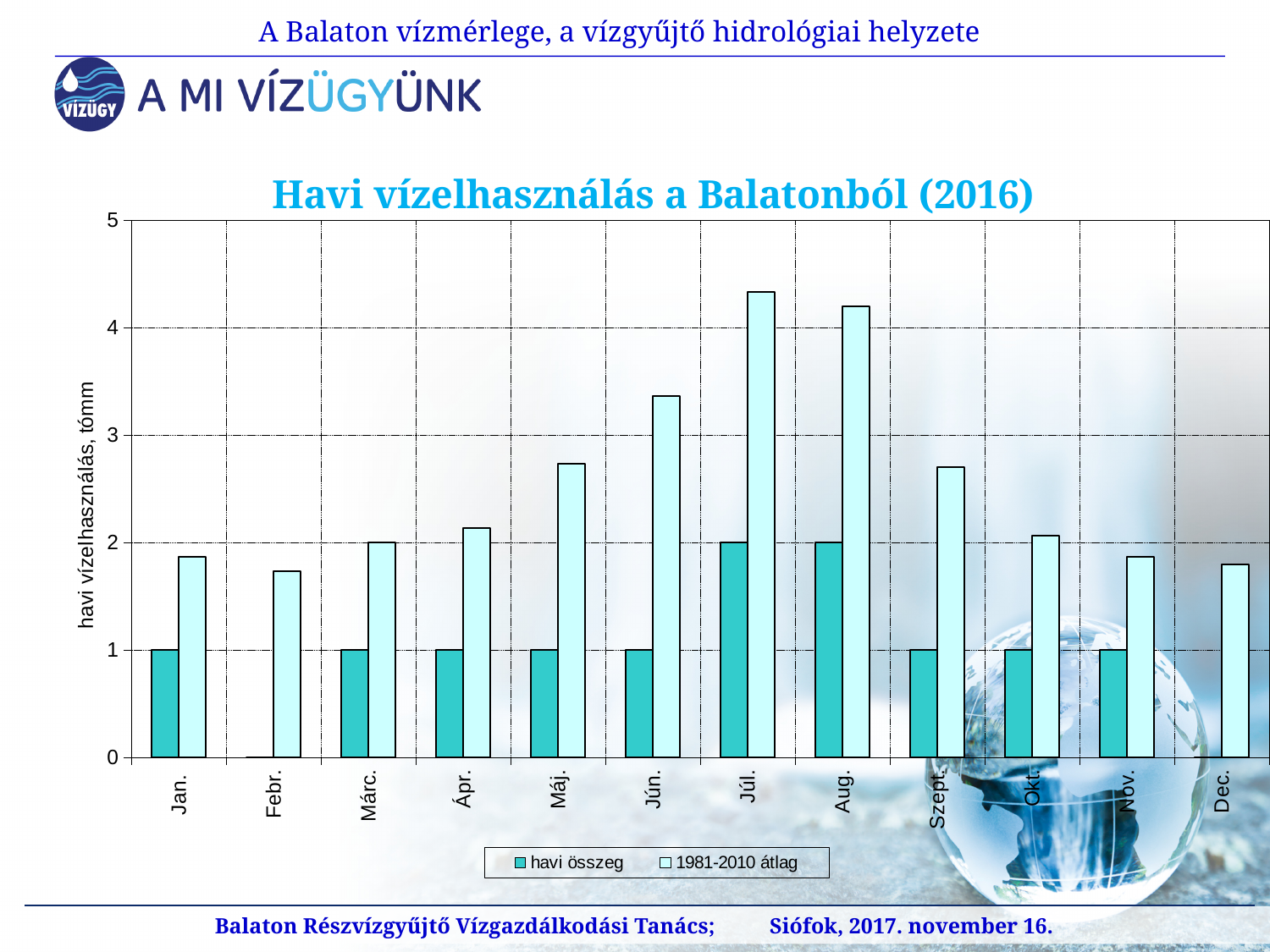
Is the '1981-2010 átlag' value for Jún. greater or less than 3? greater What is the 'havi összeg' value for Júl.? 2 Is the '1981-2010 átlag' value for Jan. greater or less than 2? less What is the difference between the 'havi összeg' values for Júl. and Jan.? 1 Which is larger, the '1981-2010 átlag' value for Jún. or for Máj.? Jún. What is the title of the chart? Havi vízelhasználás a Balatonból (2016) What type of chart is shown on the slide? bar chart How many series does the legend list? 2 Which month has the highest '1981-2010 átlag' value? Júl. How many months (categories) are shown on the x axis? 12 Does the '1981-2010 átlag' series rise or fall from Jan. to Júl.? rise What is the 'havi összeg' value for Jan.? 1